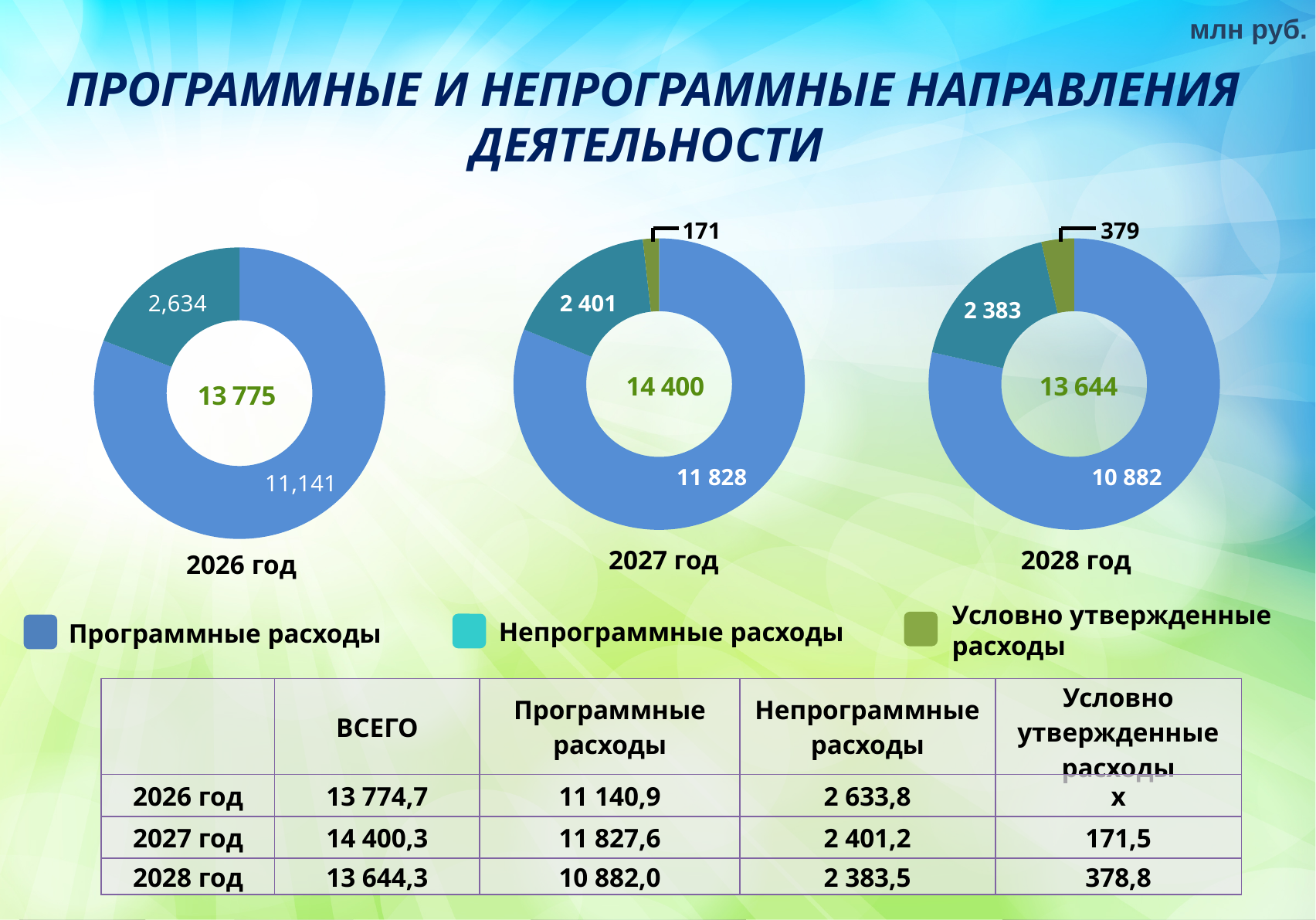
In the 2028 год chart, what is the value shown for Программные расходы? 10 882 In the 2028 год chart, which category has the smallest slice? Условно утвержденные расходы In the 2026 год chart, what is the value shown for Программные расходы? 11,141 In the 2027 год chart, what is the value shown for Условно утвержденные расходы? 171 In the 2028 год chart, what is the difference between Непрограммные расходы and Условно утвержденные расходы? 2 004 Which is larger: Непрограммные расходы in the 2027 год chart or in the 2028 год chart? 2027 год In the 2026 год chart, what is the value shown for Непрограммные расходы? 2,634 What total is printed in the centre of the 2027 год chart? 14 400 In the 2027 год chart, which category has the largest slice? Программные расходы How many series does the legend list? 3 What kind of chart is used for each year on the slide? Donut (pie) chart In the 2028 год chart, what is the value shown for Непрограммные расходы? 2 383